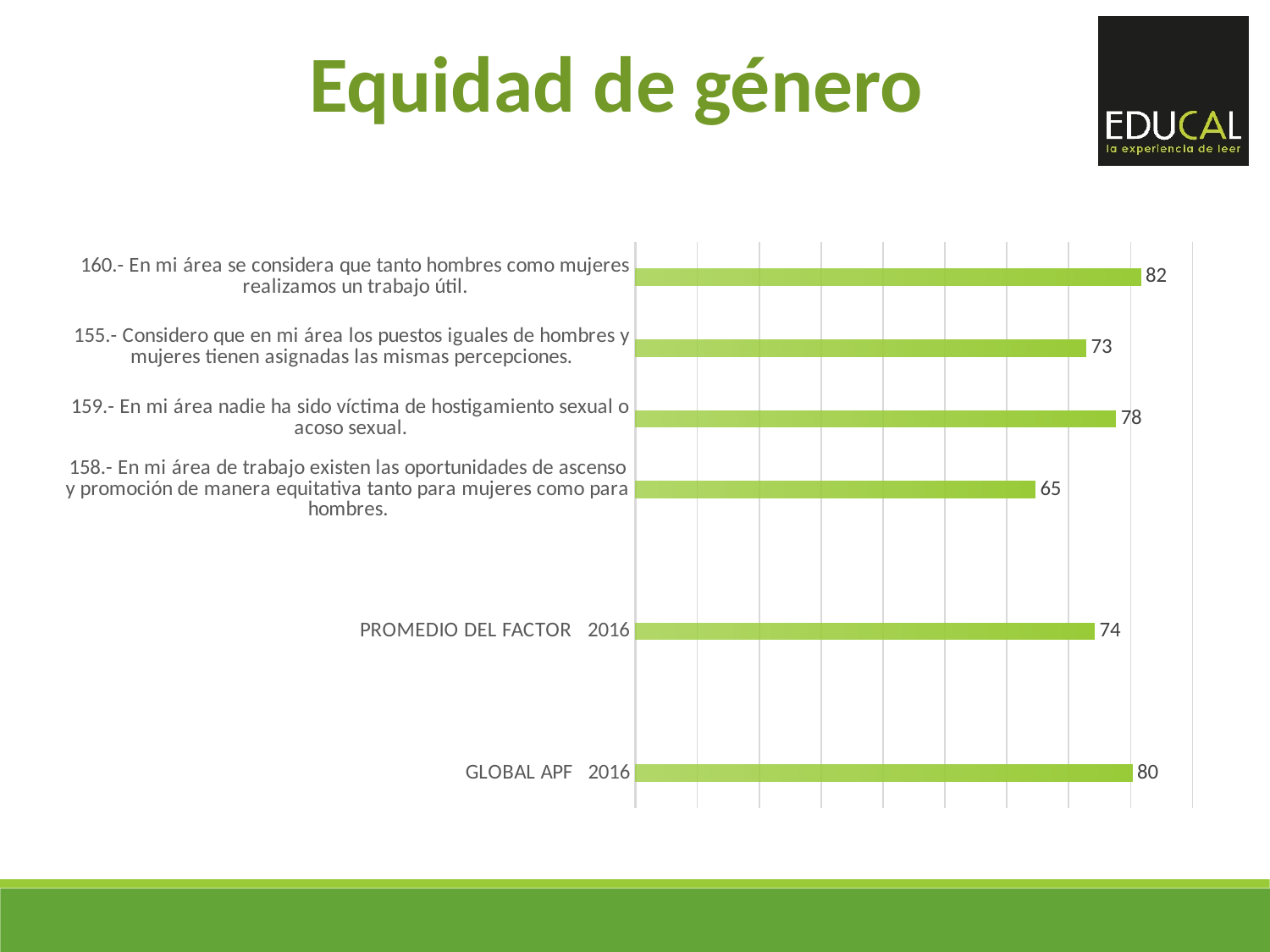
What is the difference between the value for item 160 and the value for item 158? 17 What is the value for item 155 (Considero que en mi área los puestos iguales de hombres y mujeres tienen asignadas las mismas percepciones)? 73 What is the value for item 160 (En mi área se considera que tanto hombres como mujeres realizamos un trabajo útil)? 82 What is the value for PROMEDIO DEL FACTOR 2016? 74 Which is larger, the value for GLOBAL APF 2016 or the value for PROMEDIO DEL FACTOR 2016? GLOBAL APF 2016 What is the value for GLOBAL APF 2016? 80 Which category has the lowest value? 158.- En mi área de trabajo existen las oportunidades de ascenso y promoción de manera equitativa tanto para mujeres como para hombres. How many bars are plotted in the chart? 6 Which category has the highest value? 160.- En mi área se considera que tanto hombres como mujeres realizamos un trabajo útil. What is the value for item 158 (oportunidades de ascenso y promoción de manera equitativa)? 65 What is the value for item 159 (En mi área nadie ha sido víctima de hostigamiento sexual o acoso sexual)? 78 What kind of chart is shown on the slide? Bar chart